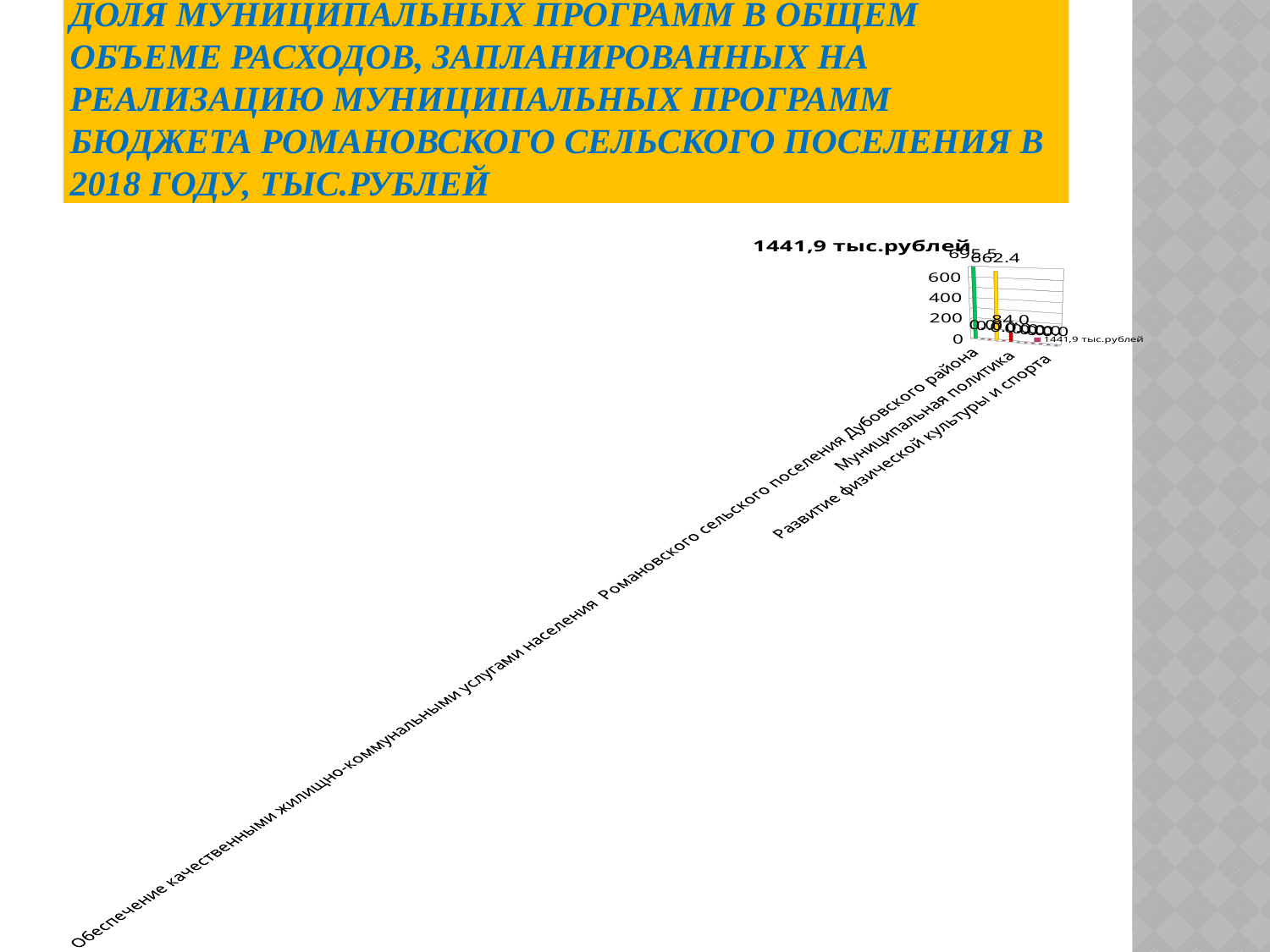
Is the value for Обеспечение качественными жилищно-коммунальными услугами населения Романовского сельского поселения Дубовского района greater or less than 400? greater Is the value for Развитие физической культуры и спорта greater or less than 200? less What kind of chart is shown on the slide? bar chart Is the value for Муниципальная политика greater or less than 400? less How many series does the chart legend list? 1 What is the value for Развитие физической культуры и спорта? 0.0 Which is larger, the value for Муниципальная политика or the value for Развитие физической культуры и спорта? Муниципальная политика What is the highest tick value shown on the chart's vertical axis? 600 What is the title of the chart? 1441,9 тыс.рублей